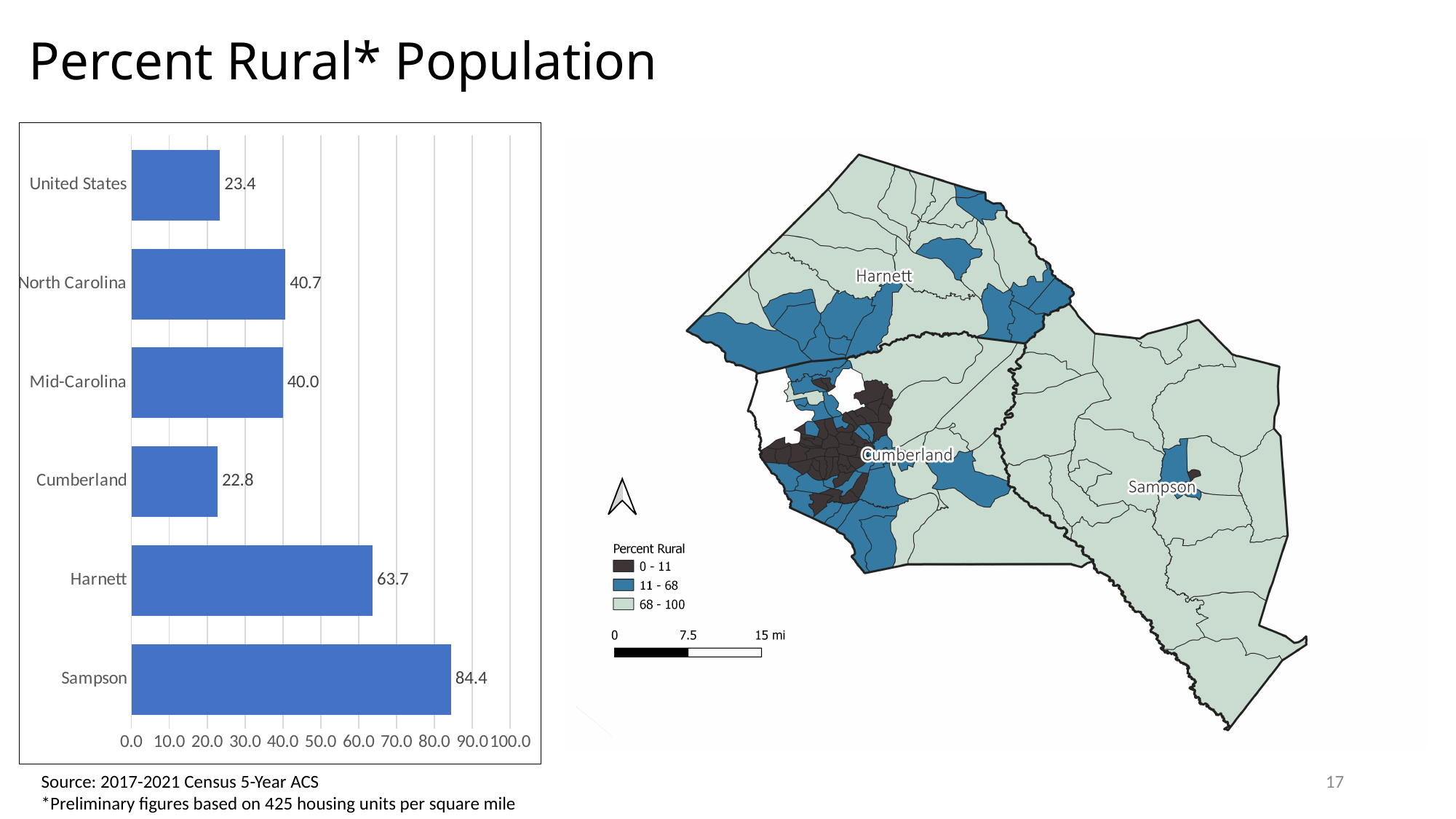
Which category has the lowest value in the bar chart? Cumberland What is the difference between the values for Sampson and Harnett in the bar chart? 20.7 Is the value for Harnett in the bar chart greater or less than 60.0? greater What is the difference between the values for North Carolina and Mid-Carolina in the bar chart? 0.7 What is the percent rural population value for Sampson in the bar chart? 84.4 What is the value shown for Cumberland in the bar chart? 22.8 How many categories are shown in the bar chart? 6 What is the value shown for North Carolina in the bar chart? 40.7 Which category has the highest value in the bar chart? Sampson What is the value shown for the United States in the bar chart? 23.4 What kind of chart is shown on the left of the slide? bar chart Which has a larger value in the bar chart, Harnett or Mid-Carolina? Harnett